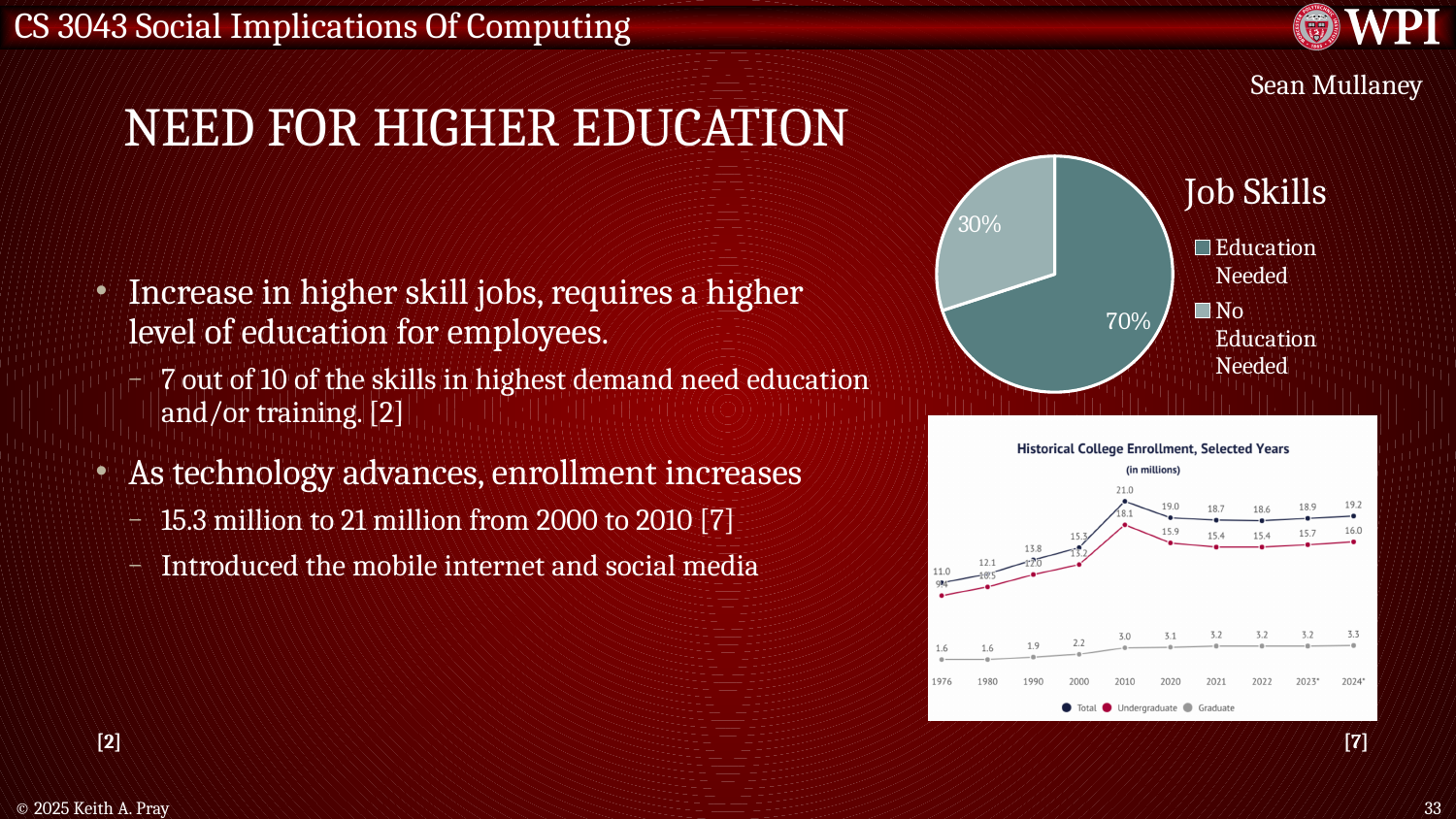
How many series does the legend of the Historical College Enrollment chart list? 3 In the Job Skills pie chart, what share of the pie is labelled Education Needed? 70% How many years are shown on the x axis of the Historical College Enrollment chart? 10 In the Job Skills pie chart, what percentage is shown for No Education Needed? 30% In the Historical College Enrollment chart, what is the Undergraduate value for 2024*? 16.0 What kind of chart is the Historical College Enrollment chart? Line chart In the Historical College Enrollment chart, what is the difference between the Total values for 2010 and 2000? 5.7 In the Historical College Enrollment chart, what is the Total enrollment value for 2010? 21.0 In the Historical College Enrollment chart, what is the Graduate value for 2000? 2.2 In the Job Skills pie chart, which slice is larger, Education Needed or No Education Needed? Education Needed How many entries does the legend of the Job Skills pie chart list? 2 In the Historical College Enrollment chart, in which year does the Total series reach its highest value? 2010